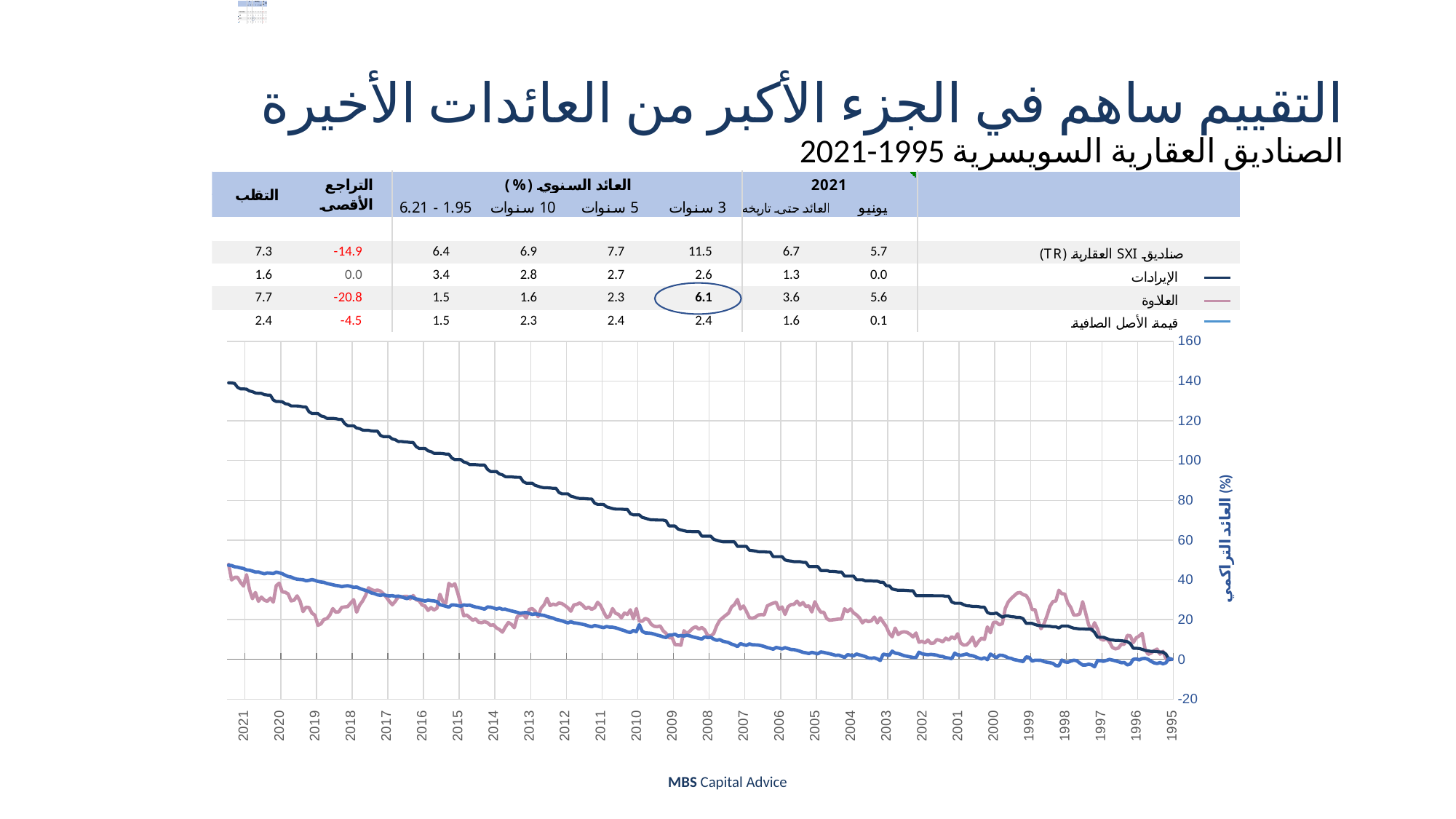
What is the highest tick value shown on the y axis of the chart? 160 Is the value of العلاوة in 2015 greater or less than 60? less What kind of chart is shown on the slide? line chart Is the value of الإيرادات in 2021 greater or less than 120? greater Which series reaches the highest value on the chart? الإيرادات How many year labels are shown on the x axis of the chart? 27 What is the label of the y axis of the chart? العائد التراكمي (%) In 2021, which is larger: الإيرادات or العلاوة? الإيرادات Does the الإيرادات line rise or fall from 1995 to 2021? rises How many series does the legend list for the chart? 3 Is the value of قيمة الأصل الصافية in 2021 greater or less than 60? less